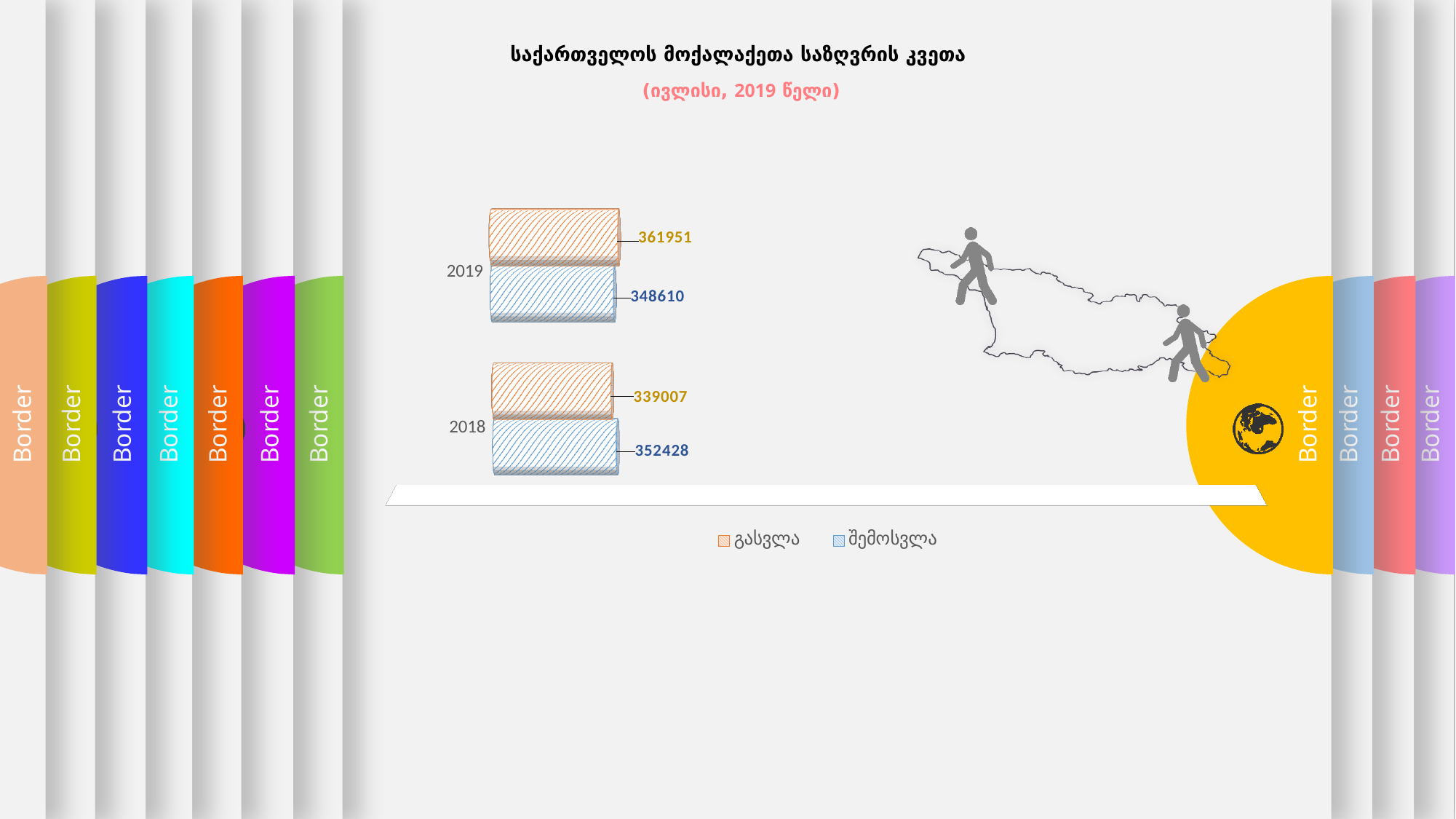
What is the value for გასვლა in 2019? 361951 What is the value for შემოსვლა in 2018? 352428 In 2018, which is larger: გასვლა or შემოსვლა? შემოსვლა What is the value for შემოსვლა in 2019? 348610 What is the difference between გასვლა and შემოსვლა in 2019? 13341 Which year has the lower value for შემოსვლა? 2019 How many years are shown on the chart? 2 What is the value for გასვლა in 2018? 339007 What is the difference between შემოსვლა and გასვლა in 2018? 13421 Which year has the higher value for გასვლა? 2019 How many series does the legend list? 2 What kind of chart is shown on the slide? Bar chart